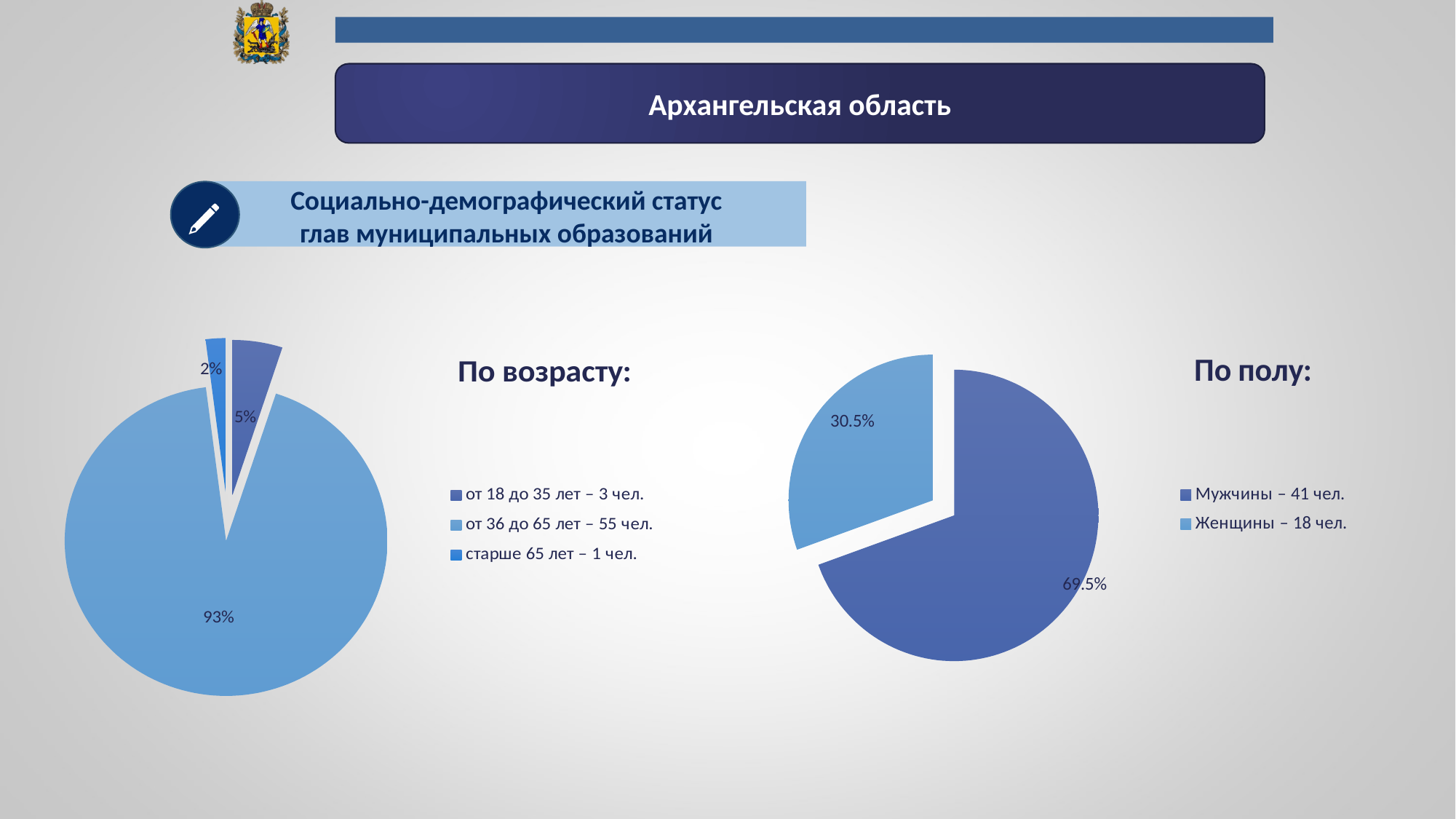
What type of chart is the 'По полу' chart? Pie chart In the 'По полу' chart, what percentage is shown for 'Мужчины'? 69.5% In the 'По возрасту' chart, which age group has the largest share? от 36 до 65 лет In the 'По полу' chart, which group is larger, 'Мужчины' or 'Женщины'? Мужчины In the 'По возрасту' chart, how many people are in the 'от 36 до 65 лет' group according to the legend? 55 чел. In the 'По возрасту' chart, which age group has the smallest share? старше 65 лет In the 'По полу' chart, what percentage is shown for 'Женщины'? 30.5% In the 'По возрасту' chart, what percentage is shown for the 'от 36 до 65 лет' slice? 93% In the 'По возрасту' chart, how many categories does the legend list? 3 In the 'По возрасту' chart, what percentage is shown for the 'от 18 до 35 лет' slice? 5% In the 'По полу' chart, what is the difference in percentage points between 'Мужчины' and 'Женщины'? 39 percentage points In the 'По возрасту' chart, what percentage is shown for the 'старше 65 лет' slice? 2%